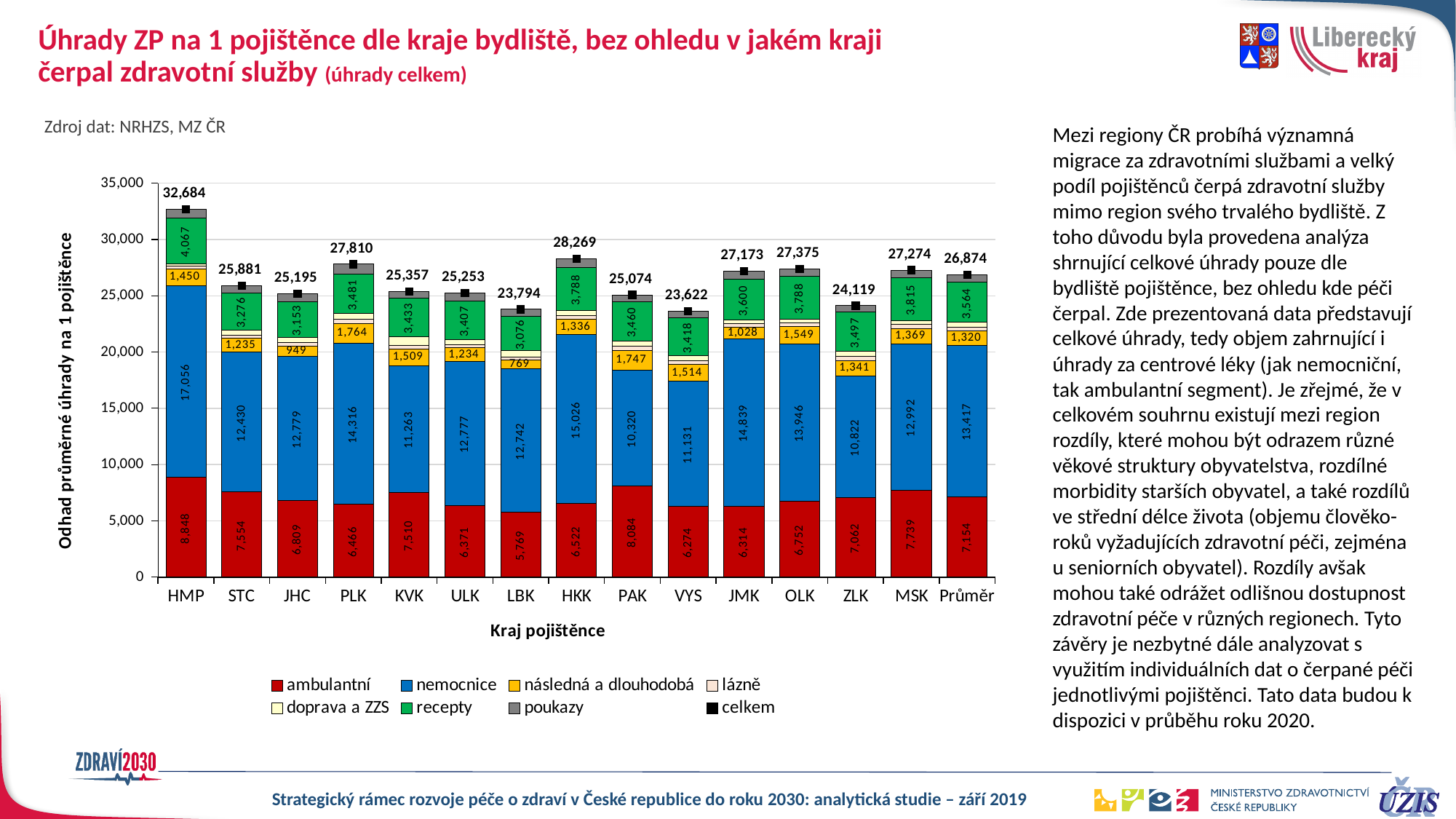
What type of chart is shown on the slide? stacked bar chart Which region has the highest nemocnice value? HMP What is the ambulantní value for LBK? 5,769 What is the total (celkem) value for HKK? 28,269 How many series does the legend list? 8 Which is larger, the nemocnice value for HKK or for PLK? HKK What is the difference between the total for HMP and the total for Průměr? 5,810 How many regions (categories) are shown on the x axis, including Průměr? 15 What is the nemocnice value for PAK? 10,320 Which region has the highest total (celkem) value? HMP Which region has the lowest total (celkem) value? VYS What is the difference between the recepty value for HMP and for STC? 791